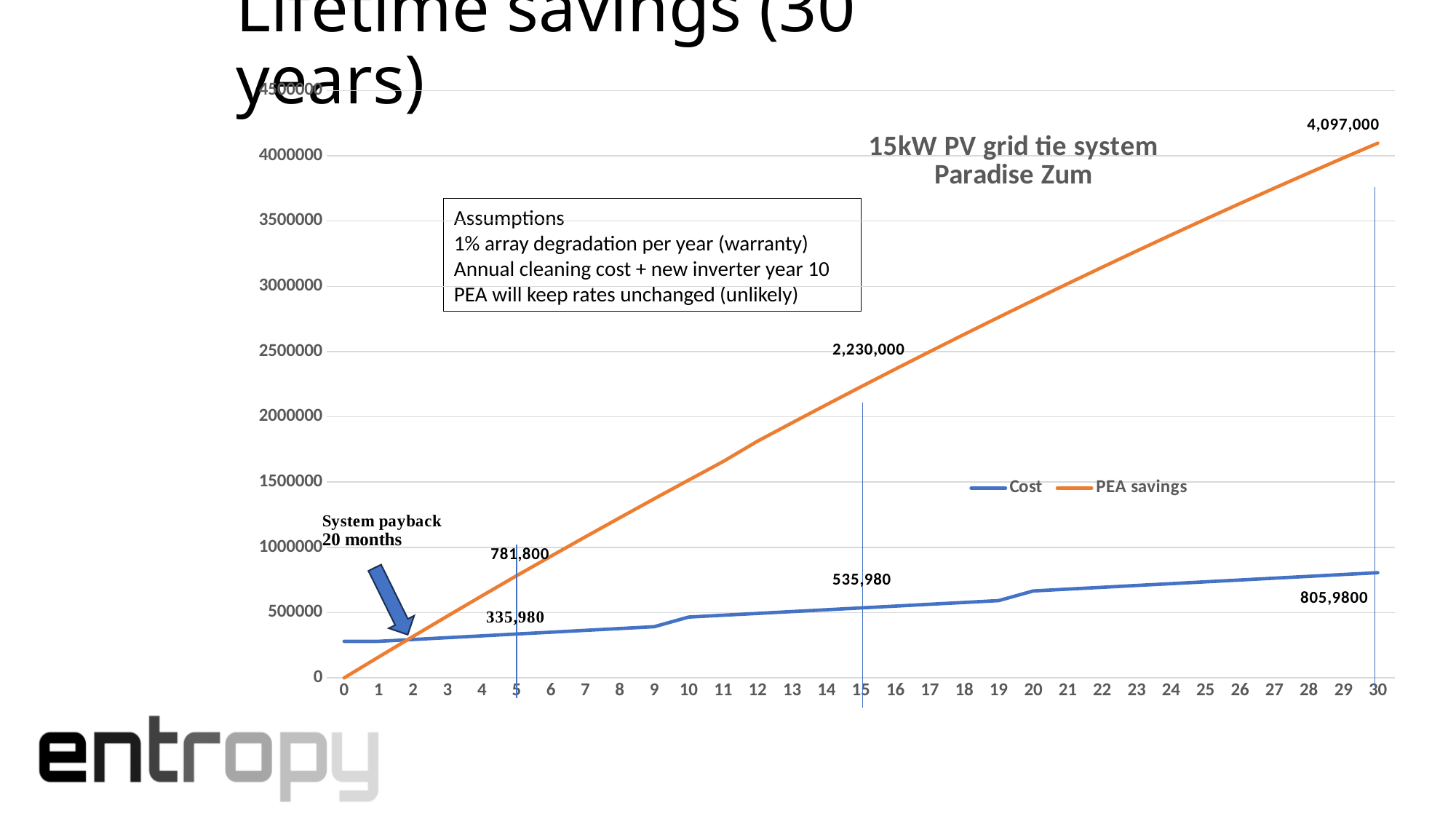
What are the two series named in the legend? Cost and PEA savings What is the difference between PEA savings and Cost at year 15? 1,694,020 At year 15, which series has the larger value, Cost or PEA savings? PEA savings What is the labelled value of PEA savings at year 15? 2,230,000 What is the labelled value of Cost at year 15? 535,980 Does the PEA savings line rise or fall as the years increase along the x axis? rise What is the labelled value of PEA savings at year 5? 781,800 What kind of chart is shown on the slide? line chart What is the labelled value of PEA savings at year 30? 4,097,000 What is the labelled value of Cost at year 5? 335,980 How many series does the legend list? 2 What is the title printed inside the chart area? 15kW PV grid tie system Paradise Zum